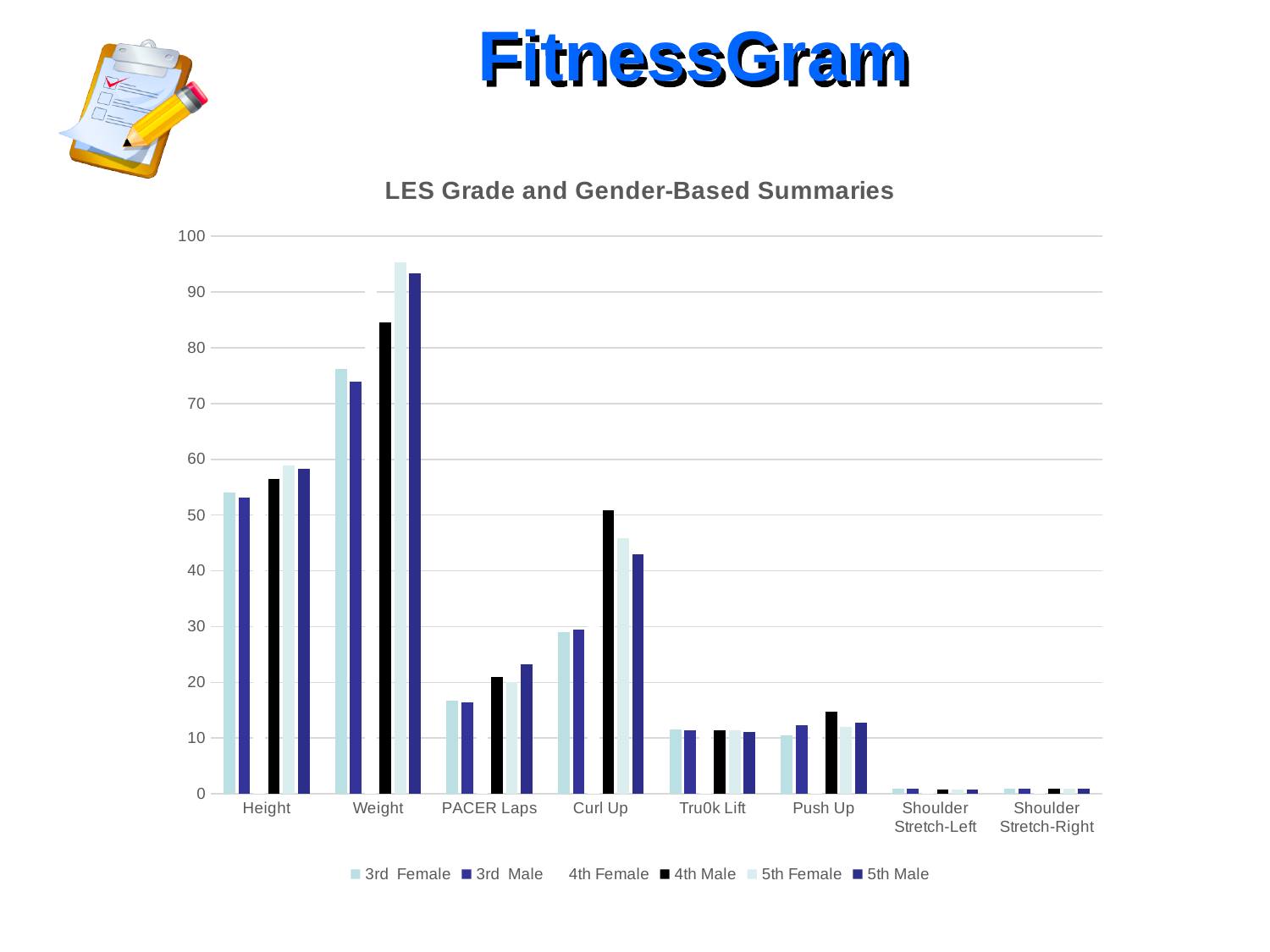
How many series does the chart's legend list? 6 How many categories are shown along the x axis of the chart? 8 What is the title of the chart? LES Grade and Gender-Based Summaries Is the value for 4th Male in the Curl Up category greater or less than 40? greater Is the value for 5th Male in the Push Up category greater or less than 20? less Is the value for 5th Female in the Weight category greater or less than 90? greater Which category has the tallest bars in the chart? Weight What kind of chart is shown on the slide? bar chart In the Curl Up category, which is larger: the value for 4th Male or the value for 5th Male? 4th Male In the Weight category, which is larger: the value for 5th Female or the value for 3rd Female? 5th Female